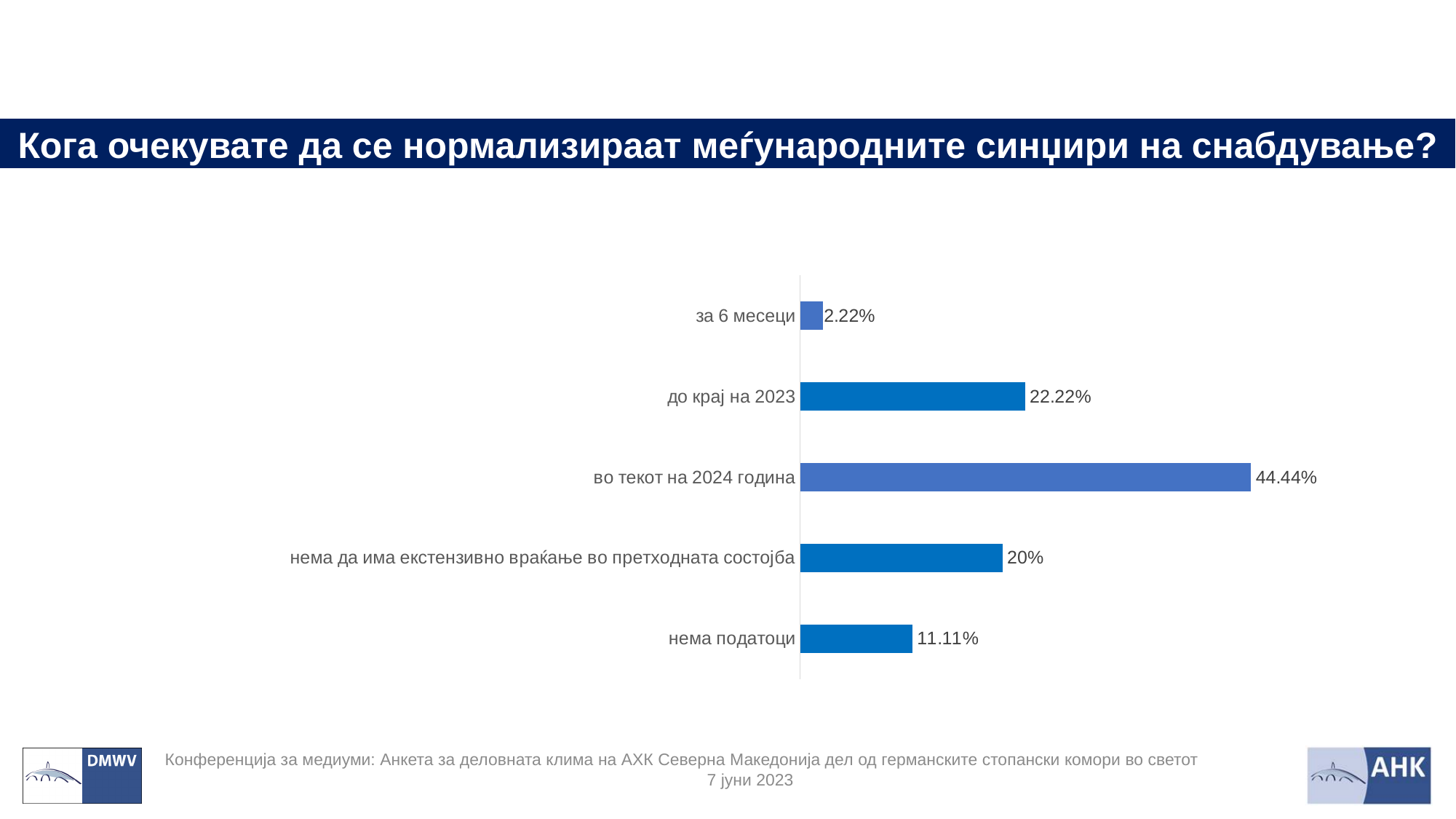
Which is larger: the value for 'до крај на 2023' or the value for 'нема податоци'? до крај на 2023 Which category has the highest value? во текот на 2024 година What is the value for 'до крај на 2023'? 22.22% What is the value for 'нема да има екстензивно враќање во претходната состојба'? 20% Which category has the lowest value? за 6 месеци What is the value for 'за 6 месеци'? 2.22% What kind of chart is shown on the slide? bar chart What is the difference between the values for 'нема да има екстензивно враќање во претходната состојба' and 'нема податоци'? 8.89% What is the value for 'во текот на 2024 година'? 44.44% How many categories are shown in the chart? 5 What is the difference between the values for 'во текот на 2024 година' and 'до крај на 2023'? 22.22% What is the value for 'нема податоци'? 11.11%